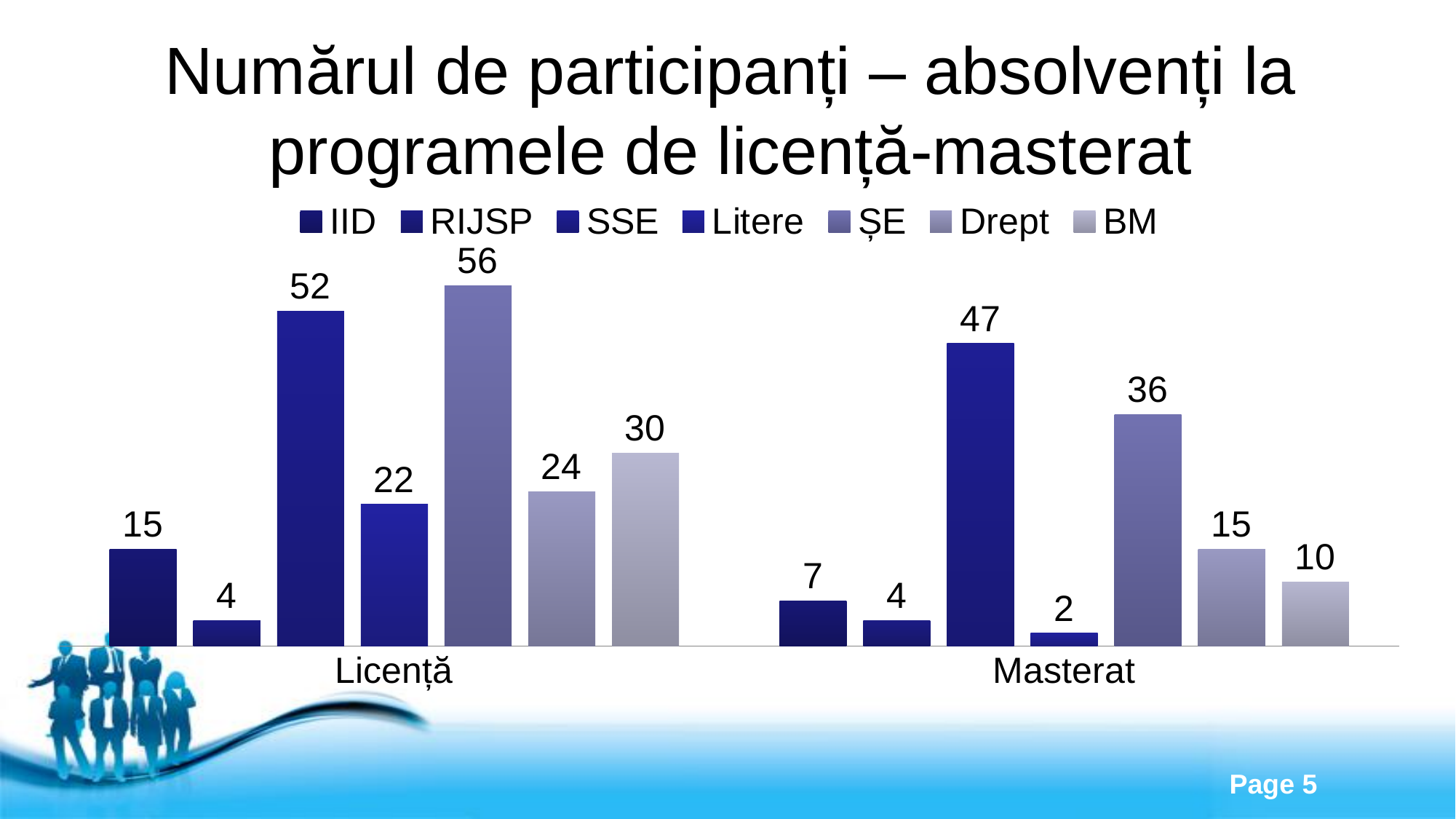
How many categories are shown on the x axis? 2 What is the value for BM in the Licență category? 30 What is the difference between the ȘE and IID values in the Licență category? 41 What is the value for ȘE in the Masterat category? 36 What is the value for Litere in the Masterat category? 2 Which is larger: the Drept value for Licență or the Drept value for Masterat? Licență How many series does the legend list? 7 What is the difference between the SSE values for Licență and Masterat? 5 What kind of chart is shown on the slide? Bar chart Which series has the highest value in the Licență category? ȘE Which series has the lowest value in the Masterat category? Litere What is the value for SSE in the Licență category? 52